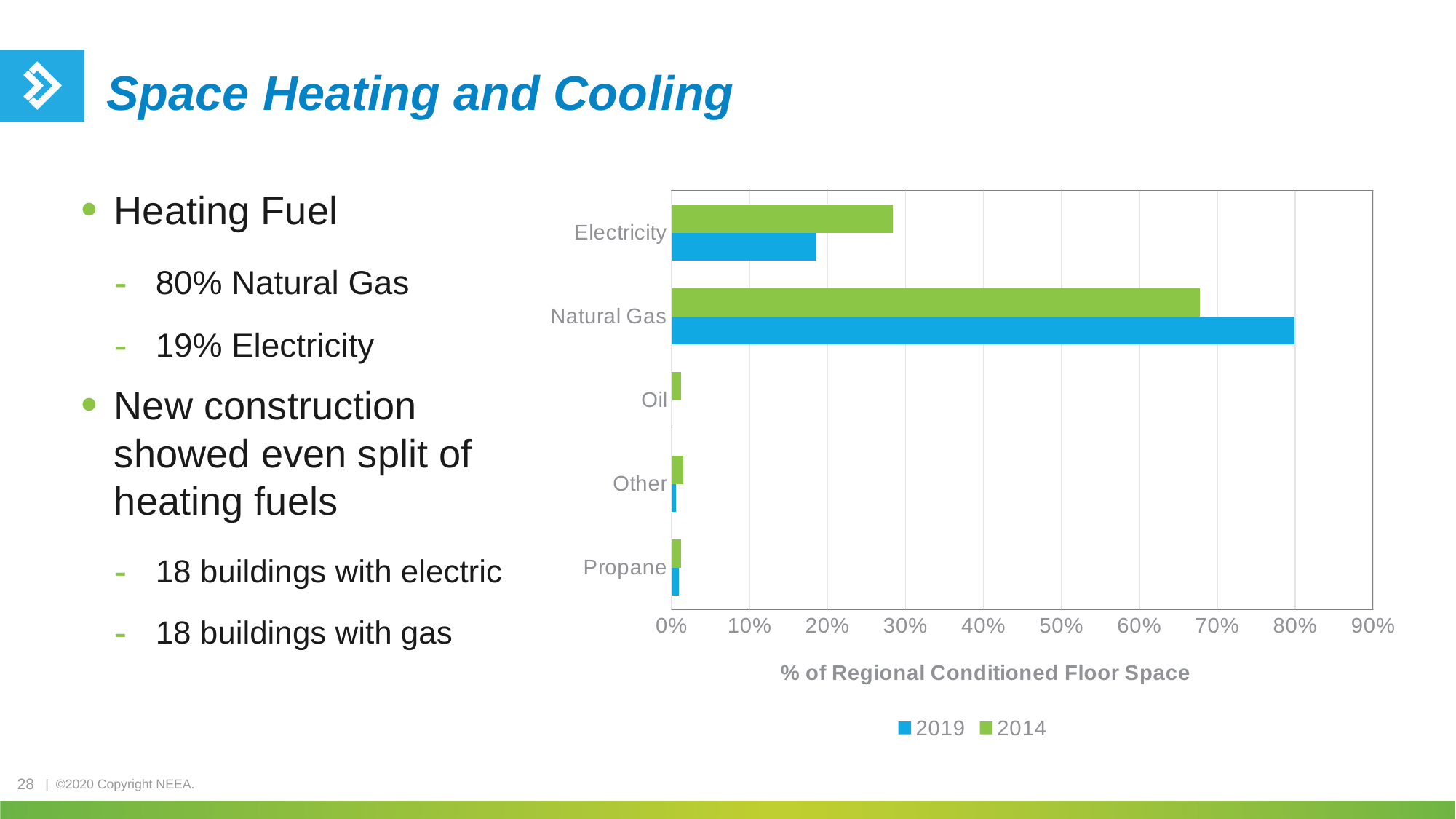
What is the 2019 value for Natural Gas? 80% For Electricity, which year has the larger value, 2019 or 2014? 2014 What is the title of the chart's horizontal axis? % of Regional Conditioned Floor Space What kind of chart is shown on the slide? bar chart Is the 2014 value for Oil greater or less than 10%? less How many series does the chart legend list? 2 For Natural Gas, which year has the larger value, 2019 or 2014? 2019 Is the 2014 value for Natural Gas greater or less than 60%? greater Which fuel category has the highest value for 2019? Natural Gas Which fuel category has the highest value for 2014? Natural Gas How many fuel categories are shown on the chart? 5 Is the 2014 value for Electricity greater or less than 20%? greater